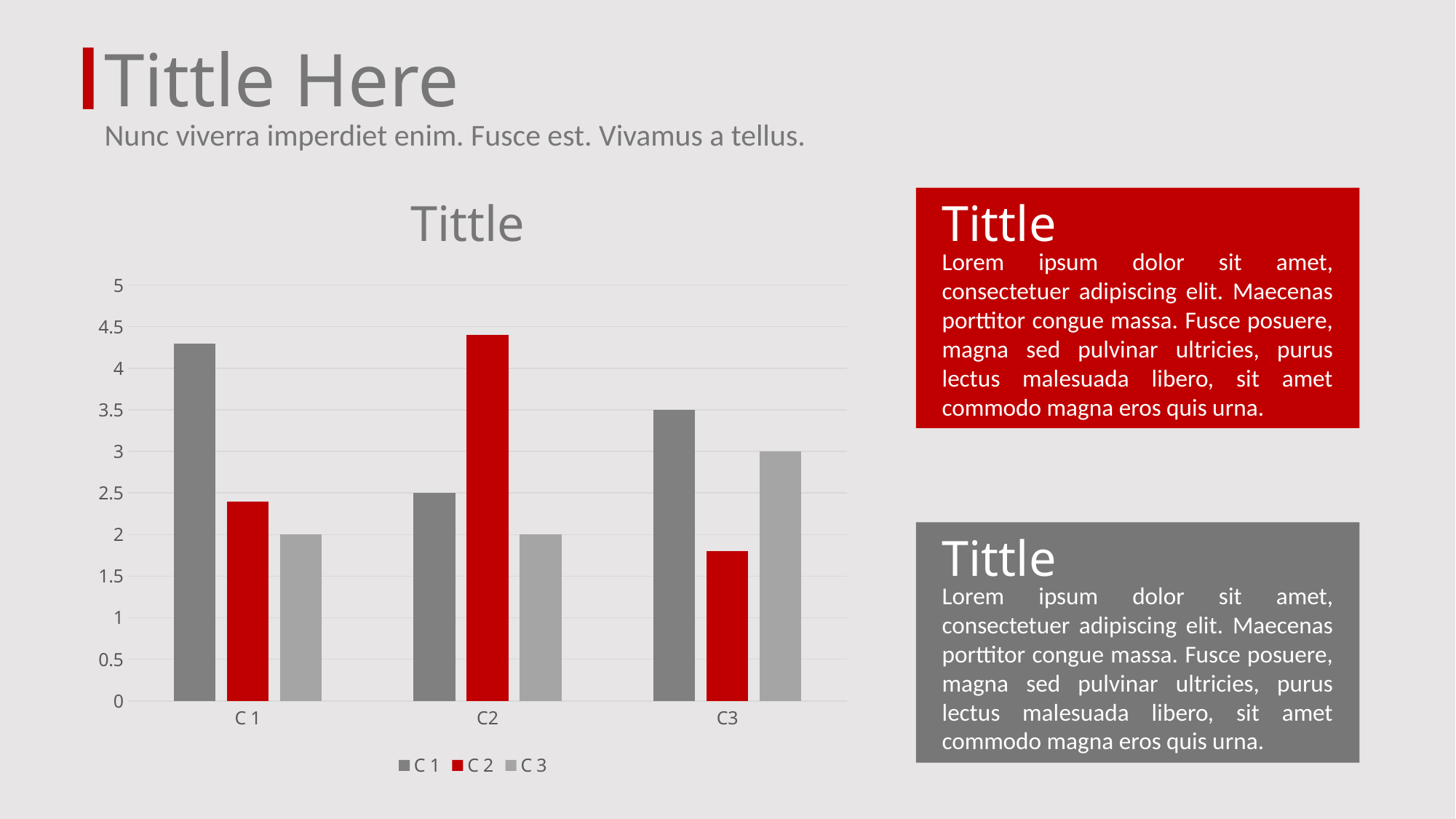
What is the title of the chart? Tittle Is the value of series C 2 for category C3 greater or less than 2? less What is the value of series C 1 for category C3? 3.5 What is the value of series C 3 for category C 1? 2 How many categories are shown on the x axis of the chart? 3 Is the value of series C 1 for category C 1 greater or less than 4? greater Which series has the highest value in category C3? C 1 How many series does the chart legend list? 3 What is the difference between series C 1 and series C 3 in category C3? 0.5 What is the value of series C 1 for category C2? 2.5 What kind of chart is shown on the slide? bar chart Which series has the lowest value in category C2? C 3